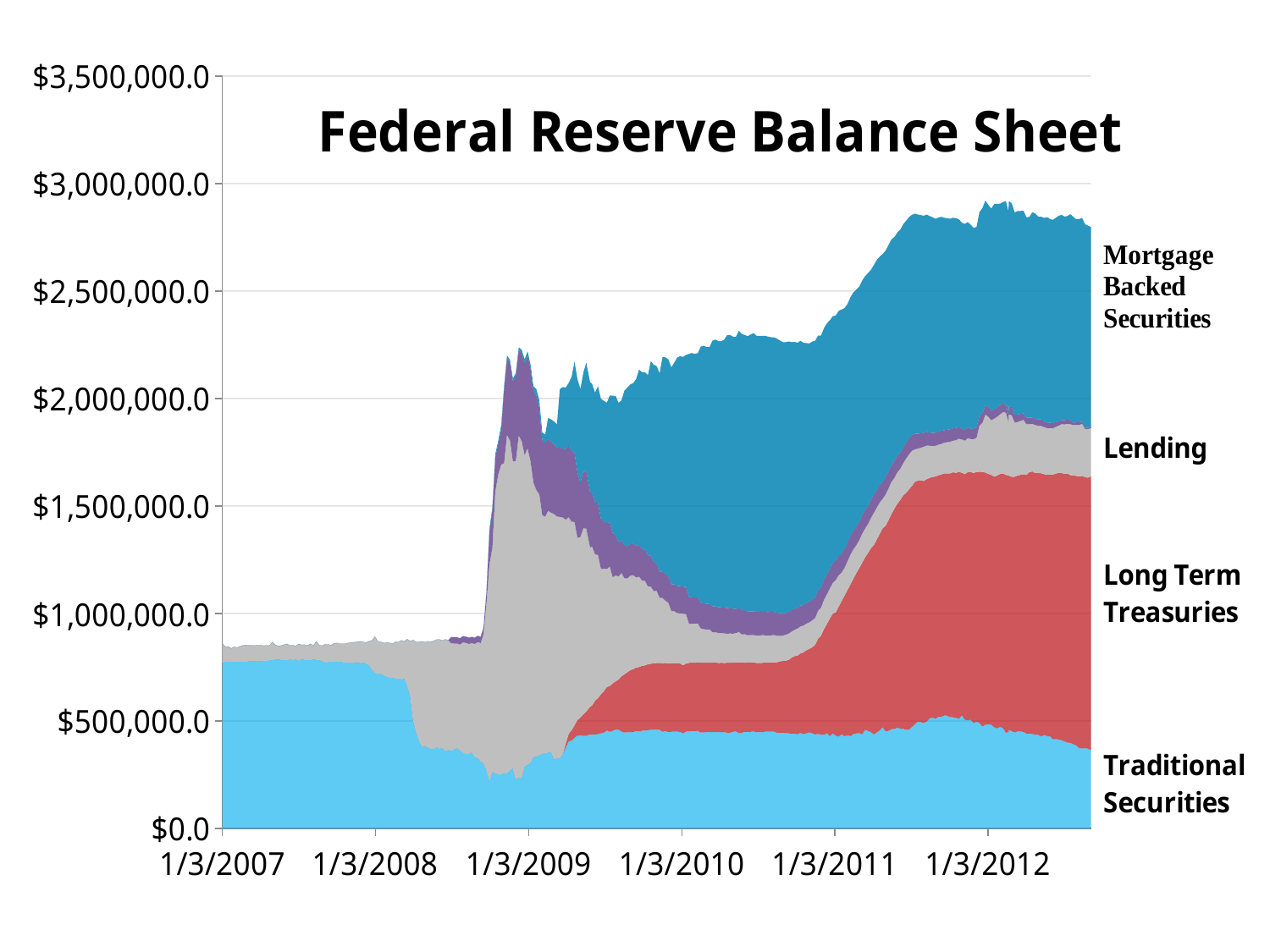
What kind of chart is shown on the slide? Stacked area chart What is the title of the chart? Federal Reserve Balance Sheet Does the total balance sheet rise or fall between 1/3/2007 and 1/3/2012? Rise Is the total balance sheet at 1/3/2007 greater or less than $1,000,000.0? less How many series are labelled on the chart? 4 Is the total balance sheet at 1/3/2012 greater or less than $3,000,000.0? less Is the total balance sheet at 1/3/2011 greater or less than $2,000,000.0? greater How many dates are labelled on the x axis? 6 At the right end of the chart, which is larger: Long Term Treasuries or Mortgage Backed Securities? Long Term Treasuries Which series is at the bottom of the stack? Traditional Securities Does the Traditional Securities series rise or fall between 1/3/2007 and 1/3/2012? Fall